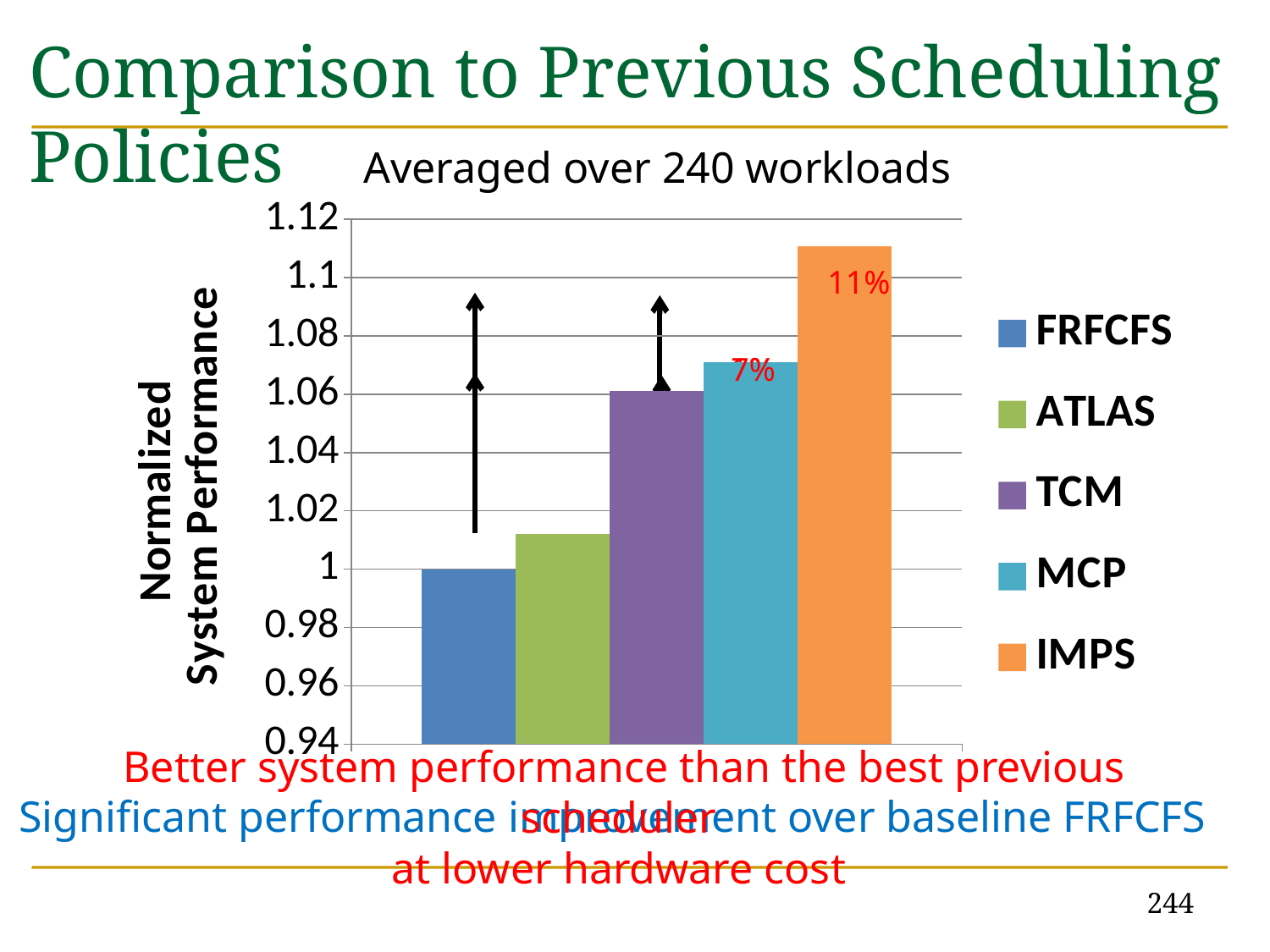
Is the normalized system performance for ATLAS greater or less than 1.02? less Is the normalized system performance for TCM greater or less than 1.04? greater Which has a higher normalized system performance, ATLAS or TCM? TCM Do the bar values rise or fall from left to right across the chart? rise How many series does the legend list? 5 Which scheduling policy has the highest normalized system performance? IMPS Which scheduling policy has the lowest normalized system performance? FRFCFS What kind of chart is shown on the slide? bar chart Is the normalized system performance for IMPS greater or less than 1.1? greater Which has a higher normalized system performance, MCP or IMPS? IMPS What is the normalized system performance of FRFCFS? 1 What is the title of the chart? Averaged over 240 workloads